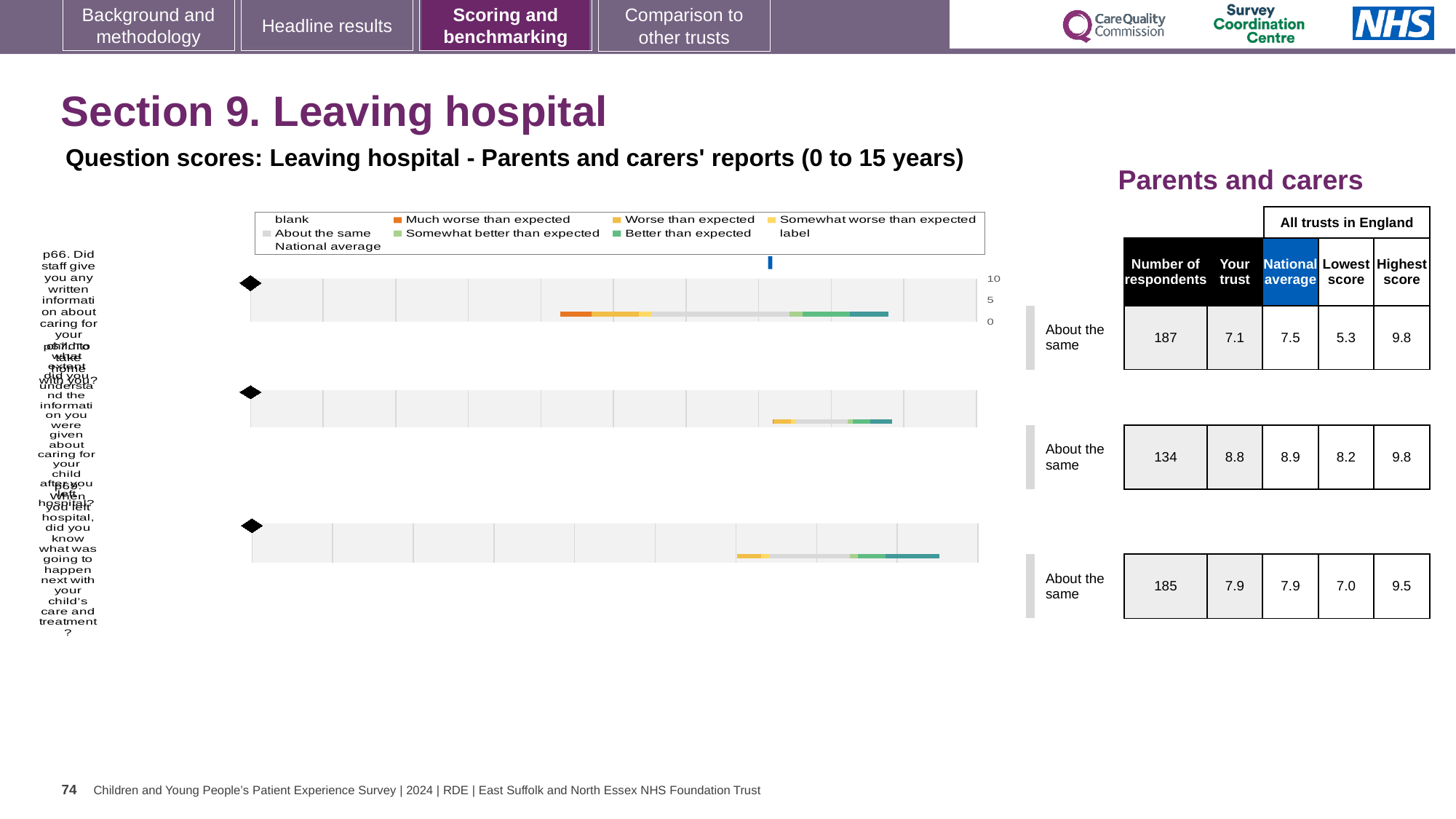
In the chart legend, which colour represents 'Much worse than expected'? orange How many question rows (charts) are plotted on the slide? 3 What kind of chart is used to show the question scores on this slide? bar chart For the top chart row (p66), what is the 'Your trust' score shown in the table? 7.1 For the top chart row, which is larger: the 'Your trust' score or the national average? national average What benchmark category is given for all three chart rows? About the same For the middle chart row, what is the national average score? 8.9 Which chart row has the most respondents? the top row (187) Which chart row has the fewest respondents? the middle row (134) For the top chart row, what is the difference between the highest score and the lowest score across all trusts in England? 4.5 What is the maximum value shown on the score axis of the top chart? 10 For the bottom chart row, how many respondents are listed? 185